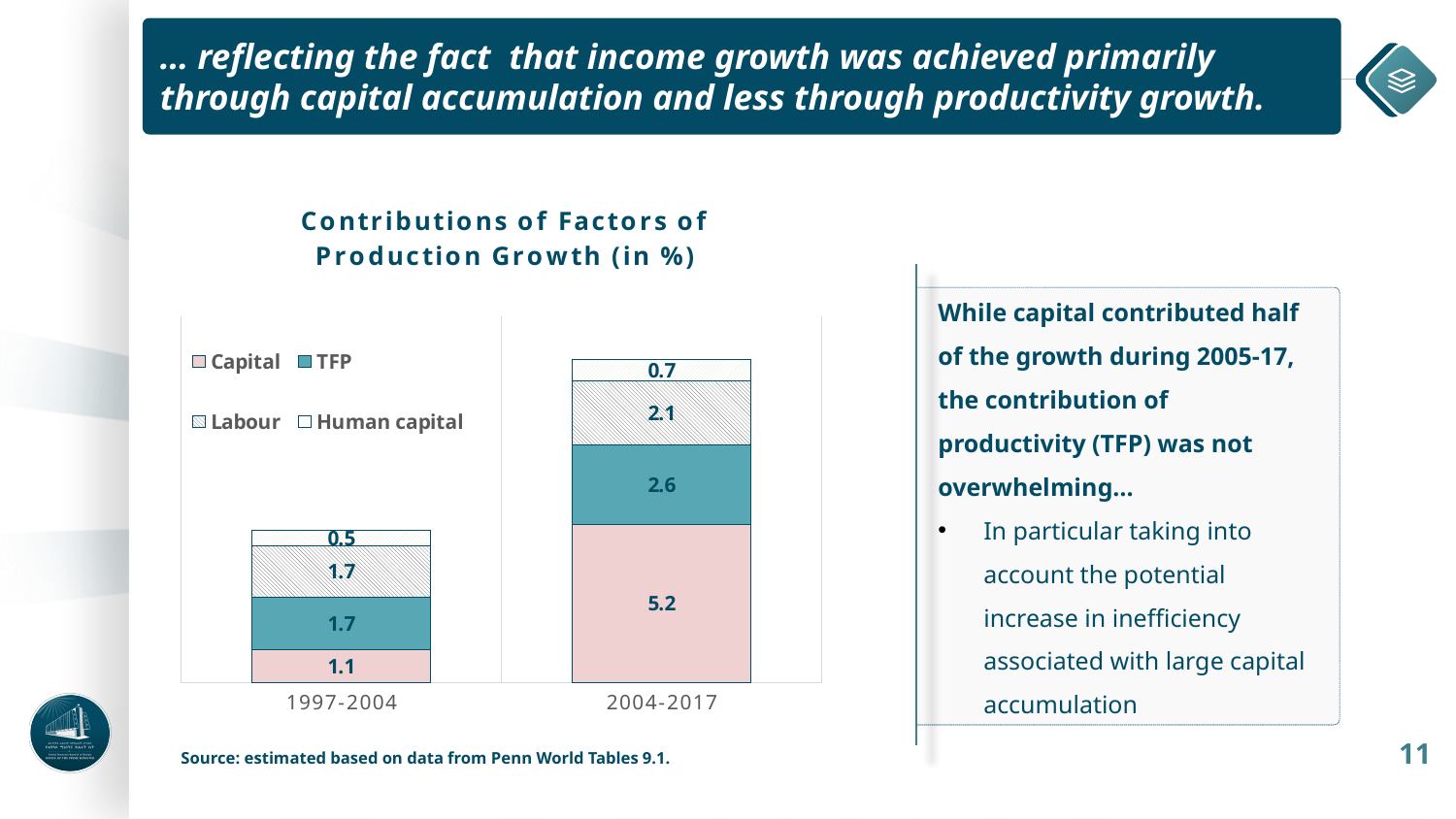
What is the TFP contribution for 1997-2004? 1.7 What is the Human capital contribution for 2004-2017? 0.7 Which factor has the largest contribution in 2004-2017? Capital How many series does the legend list? 4 What is the Labour contribution for 1997-2004? 1.7 Which factor has the smallest contribution in 2004-2017? Human capital What kind of chart is shown on the slide? Stacked bar chart What is the Capital contribution for 2004-2017? 5.2 What is the difference between the Capital contribution in 2004-2017 and in 1997-2004? 4.1 Which period has the larger Capital contribution? 2004-2017 What is the total of the stacked bar for 2004-2017? 10.6 What is the total of the stacked bar for 1997-2004? 5.0